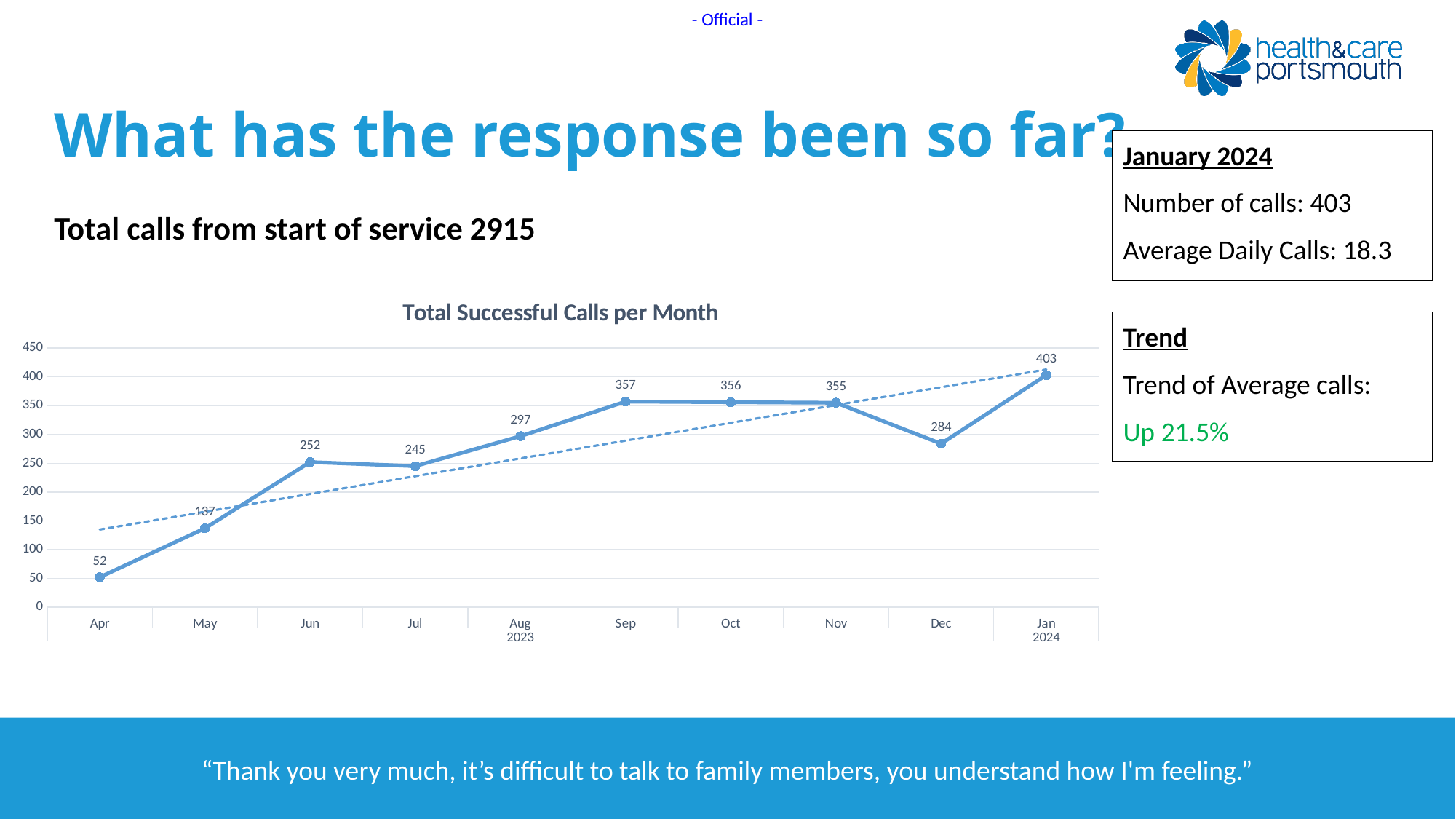
Which month has the highest value in the Total Successful Calls per Month chart? Jan 2024 What is the value for Dec in the Total Successful Calls per Month chart? 284 What kind of chart is the Total Successful Calls per Month chart? Line chart What is the difference between the values for Jan 2024 and Dec in the Total Successful Calls per Month chart? 119 What is the value for Aug 2023 in the Total Successful Calls per Month chart? 297 How many months are plotted in the Total Successful Calls per Month chart? 10 What is the difference between the values for Jun and May in the Total Successful Calls per Month chart? 115 Which is larger in the Total Successful Calls per Month chart, the value for Jun or the value for Jul? Jun Which month has the lowest value in the Total Successful Calls per Month chart? Apr What is the value for Apr in the Total Successful Calls per Month chart? 52 What is the title of the chart on the slide? Total Successful Calls per Month Is the value for Sep in the Total Successful Calls per Month chart greater or less than 300? greater